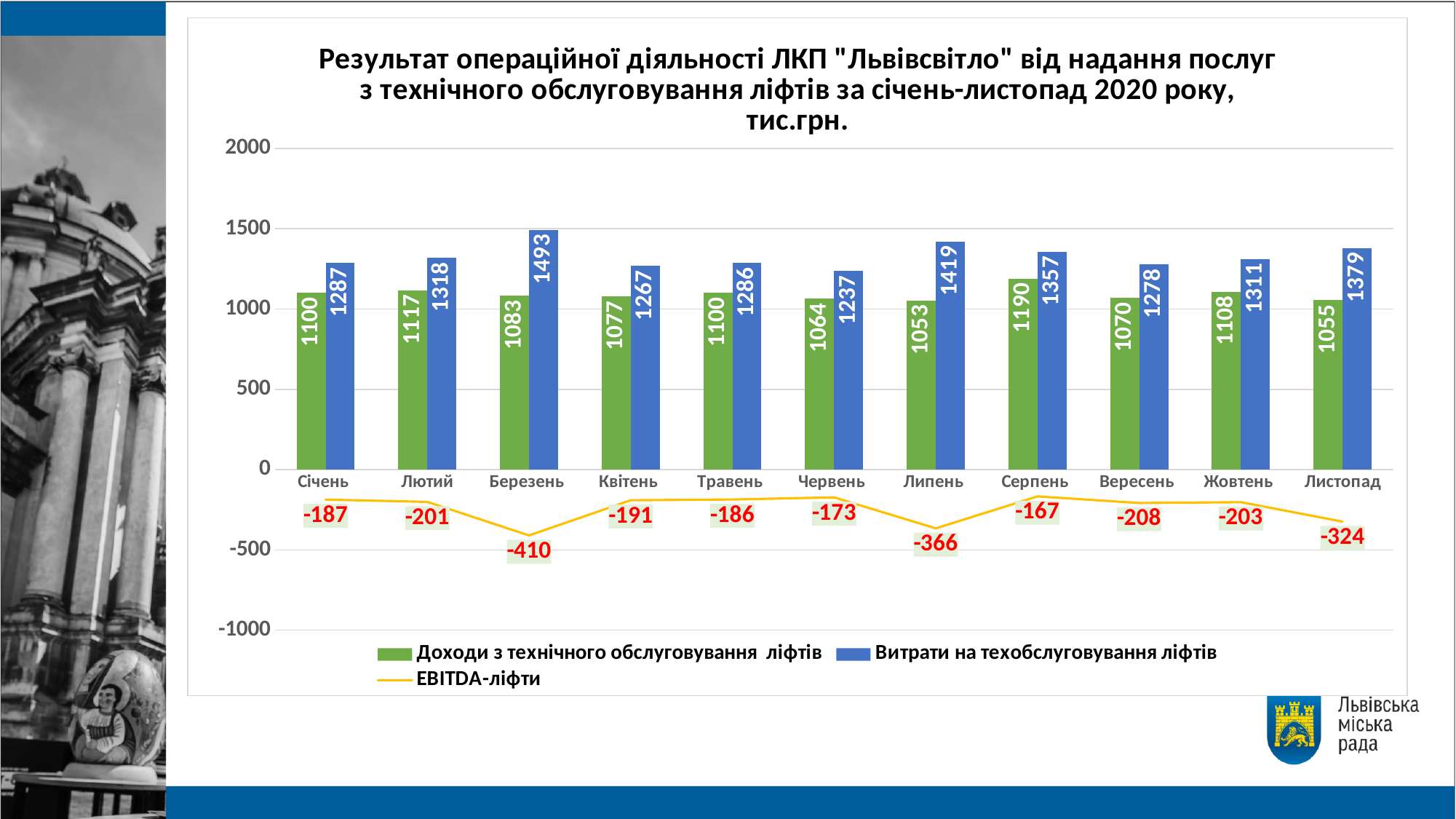
In which month is the EBITDA-ліфти value the lowest? Березень How many series does the legend list? 3 What is the difference between Витрати and Доходи in Листопад? 324 In which month are Доходи з технічного обслуговування ліфтів the highest? Серпень In which month are Витрати на техобслуговування ліфтів the highest? Березень What is the EBITDA-ліфти value for Серпень? -167 What is the value of Витрати на техобслуговування ліфтів for Липень? 1419 What is the value of Доходи з технічного обслуговування ліфтів for Березень? 1083 What is the EBITDA-ліфти value for Листопад? -324 How many months are shown on the x axis? 11 What kind of chart is shown on the slide? Combined bar and line chart Which month has higher Доходи з технічного обслуговування ліфтів, Серпень or Лютий? Серпень